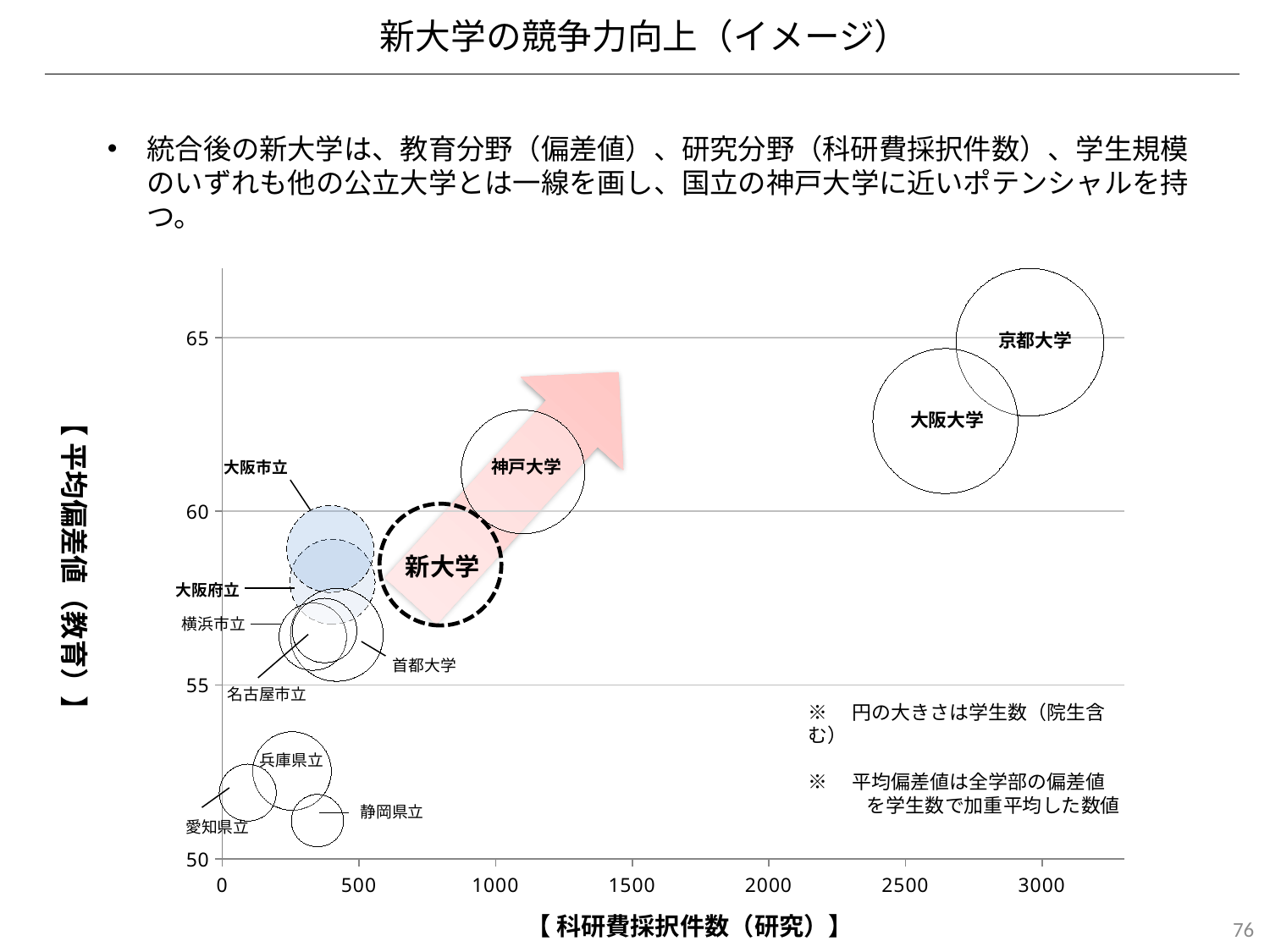
Is the 科研費採択件数 value for 神戸大学 greater or less than 1000? greater According to the note on the chart, what does the size of each circle represent? 学生数（院生含む） What kind of chart is shown on the slide? Bubble chart Which has the larger 科研費採択件数 value, 大阪大学 or 神戸大学? 大阪大学 How many labeled universities (circles) are plotted on the chart? 12 What is the label of the horizontal axis of the chart? 科研費採択件数（研究） Which university is plotted lowest on the 平均偏差値 axis? 静岡県立 Which university has the largest 科研費採択件数 value on the chart? 京都大学 Is the 平均偏差値 value for 静岡県立 greater or less than 55? less Is the 科研費採択件数 value for 大阪大学 greater or less than 2500? greater Which university is plotted highest on the 平均偏差値 axis? 京都大学